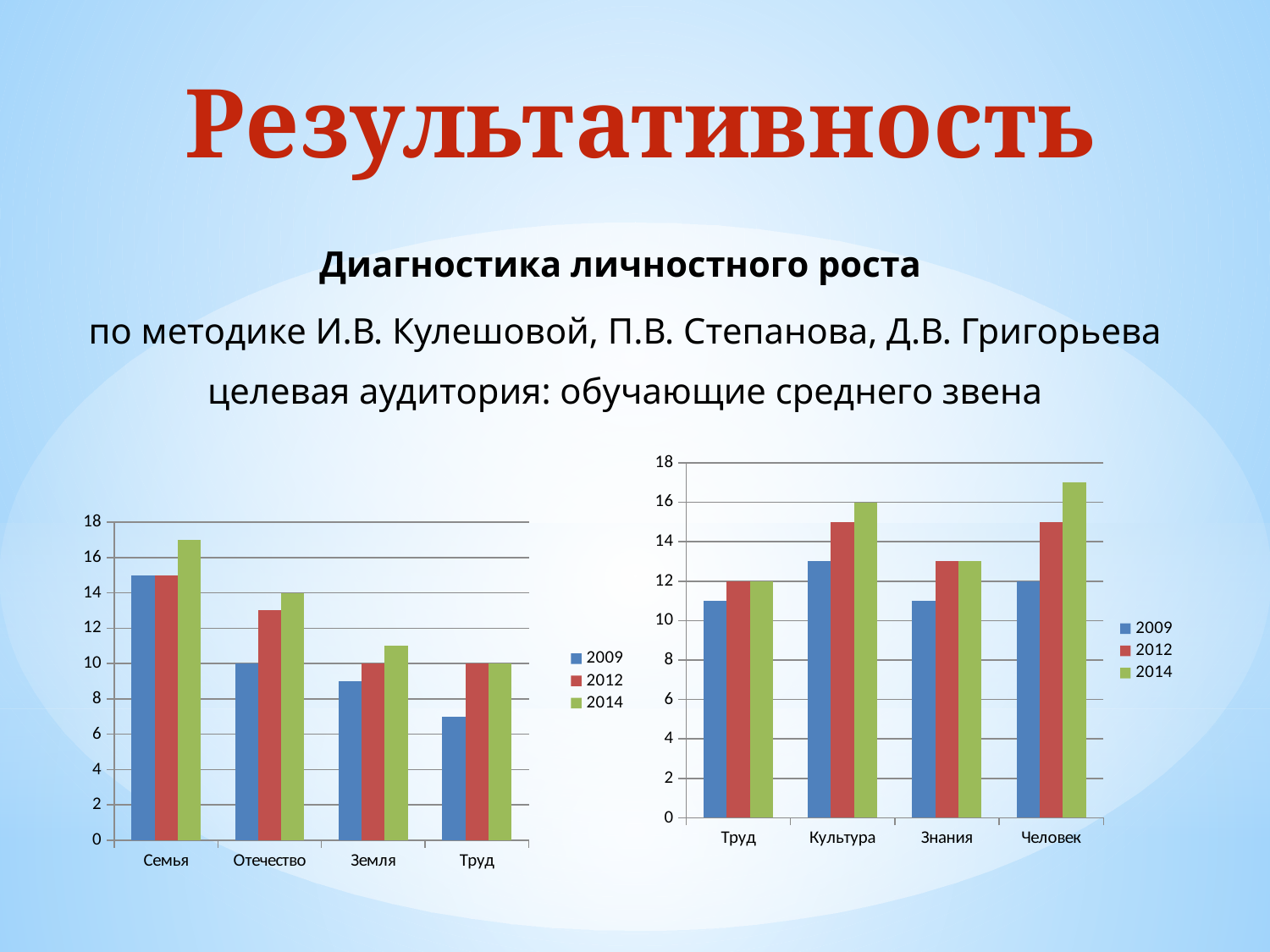
On the right chart, what is the value for Культура in 2014? 16 On the right chart, what is the difference between Культура in 2014 and Труд in 2012? 4 On the left chart, which category has the lowest 2009 value? Труд On the left chart, which category has the highest 2014 value? Семья How many series does the legend of the right chart list? 3 On the left chart, do the 2009 values rise or fall from Семья to Труд? fall On the right chart, which is larger for 2009: Культура or Знания? Культура On the right chart, what is the value for Человек in 2009? 12 On the left chart, what is the value for Отечество in 2014? 14 On the left chart, is the value for Труд in 2009 greater or less than 8? less On the right chart, is the value for Человек in 2014 greater or less than 16? greater On the left chart, is the value for Семья in 2014 greater or less than 16? greater